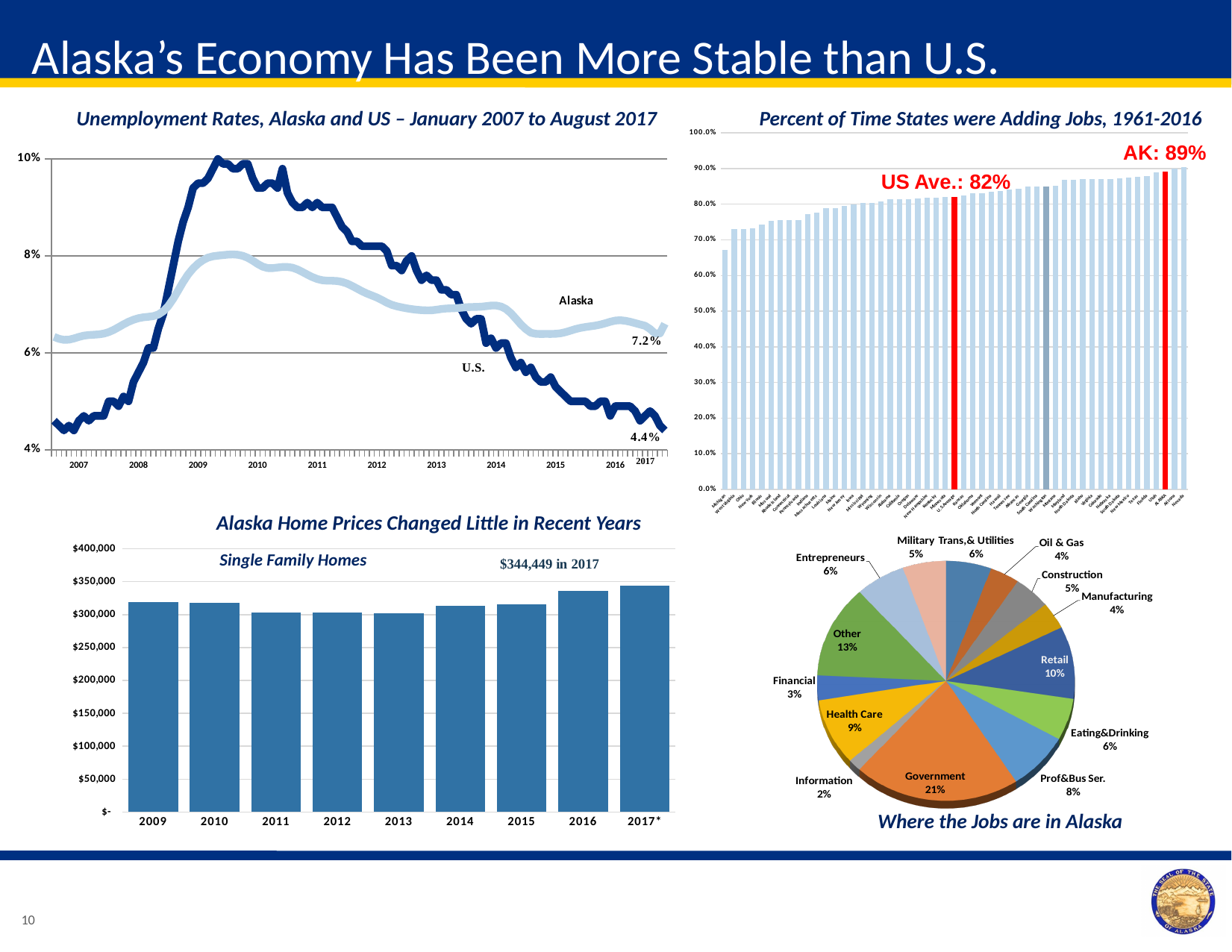
In the 'Where the Jobs are in Alaska' pie chart, which sector has the largest share? Government In the 'Percent of Time States were Adding Jobs, 1961-2016' chart, what is the value labelled for AK? 89% In the unemployment rates chart, what is the final labelled value for Alaska? 7.2% In the 'Alaska Home Prices Changed Little in Recent Years' chart, how many years are shown on the x axis? 9 In the 'Where the Jobs are in Alaska' pie chart, what share does Health Care have? 9% In the unemployment rates chart, what is the difference between the final Alaska value and the final U.S. value? 2.8% In the 'Alaska Home Prices Changed Little in Recent Years' chart, is the value for 2016 greater or less than $350,000? less In the unemployment rates chart, what is the final labelled value for the U.S.? 4.4% In the 'Percent of Time States were Adding Jobs, 1961-2016' chart, what is the labelled US average? 82% In the unemployment rates chart, which series ends higher in 2017, Alaska or U.S.? Alaska In the 'Where the Jobs are in Alaska' pie chart, which sector has the smallest share? Information In the 'Alaska Home Prices Changed Little in Recent Years' chart, what is the labelled value for 2017? $344,449